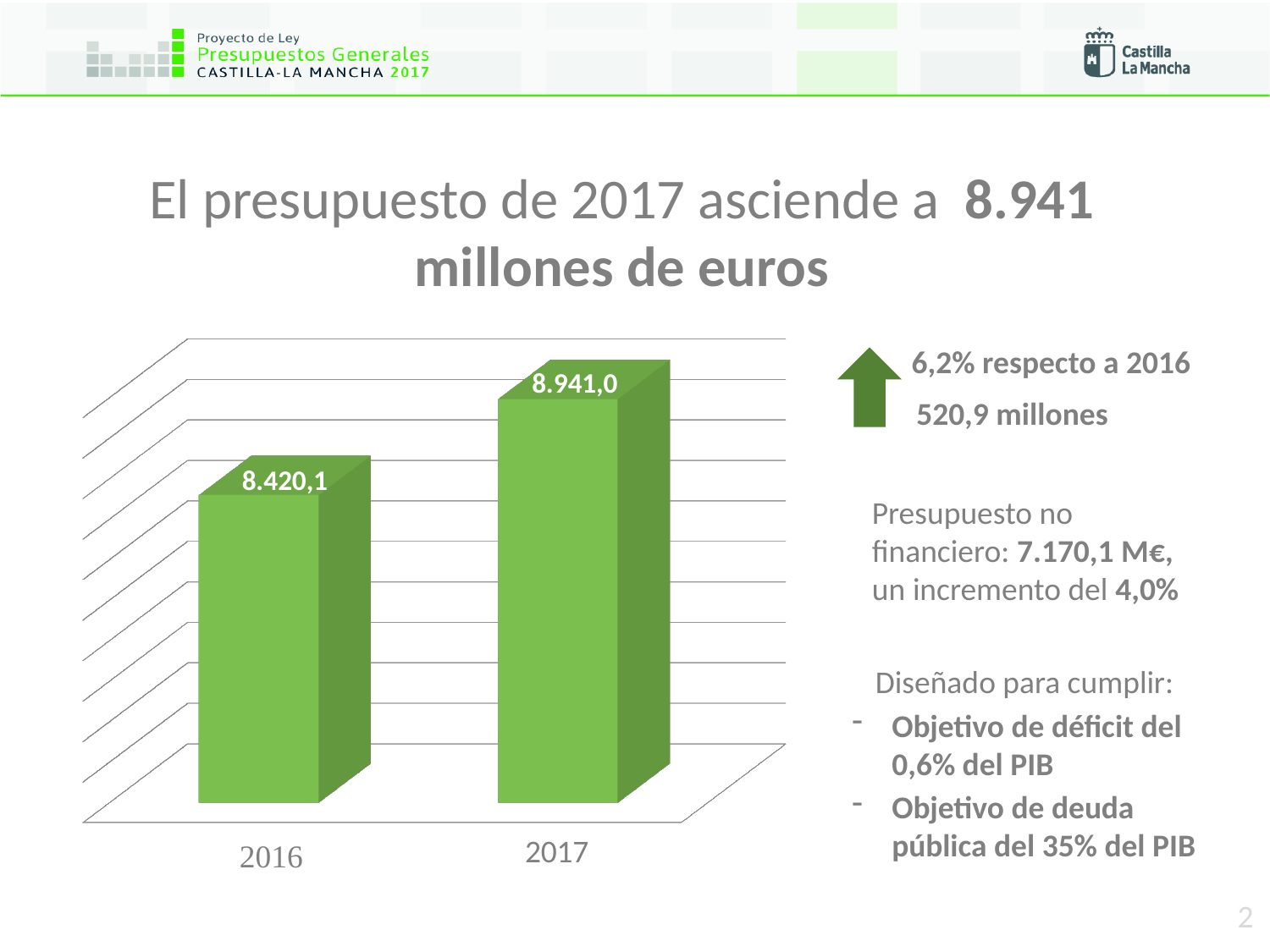
What colour are the bars in the chart? green What kind of chart is shown on the slide? bar chart How many bars are plotted in the chart? 2 Which year has the lower value in the chart? 2016 Which year has the higher value in the chart? 2017 What is the value shown for 2017? 8.941,0 Is the value for 2017 larger or smaller than the value for 2016? larger What are the two category labels on the x axis of the chart? 2016 and 2017 What is the value shown for 2016? 8.420,1 Do the values rise or fall from 2016 to 2017? rise What is the difference between the 2017 value and the 2016 value? 520,9